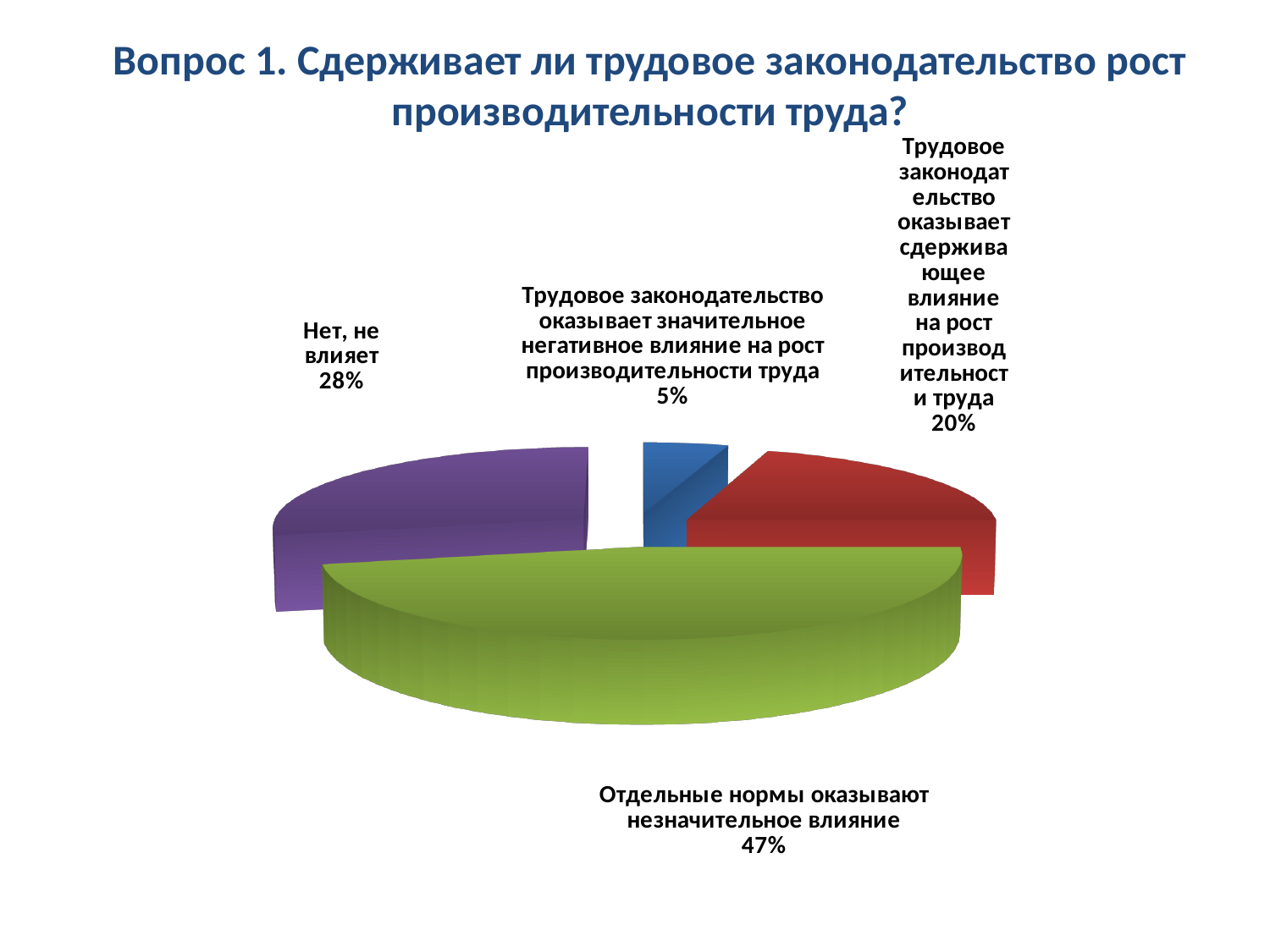
What kind of chart is shown on the slide? Pie chart What share of the pie is labelled "Трудовое законодательство оказывает значительное негативное влияние на рост производительности труда"? 5% What is the title of the chart on the slide? Вопрос 1. Сдерживает ли трудовое законодательство рост производительности труда? What share of the pie is labelled "Трудовое законодательство оказывает сдерживающее влияние на рост производительности труда"? 20% What colour is the slice labelled "Нет, не влияет"? Purple Which slice of the pie chart is the largest? Отдельные нормы оказывают незначительное влияние How many slices does the pie chart have? 4 Which is larger: the "Нет, не влияет" slice or the "Отдельные нормы оказывают незначительное влияние" slice? Отдельные нормы оказывают незначительное влияние What share of the pie is labelled "Нет, не влияет"? 28% Which slice of the pie chart is the smallest? Трудовое законодательство оказывает значительное негативное влияние на рост производительности труда What is the difference in percentage points between the "Нет, не влияет" slice and the "Трудовое законодательство оказывает сдерживающее влияние на рост производительности труда" slice? 8%